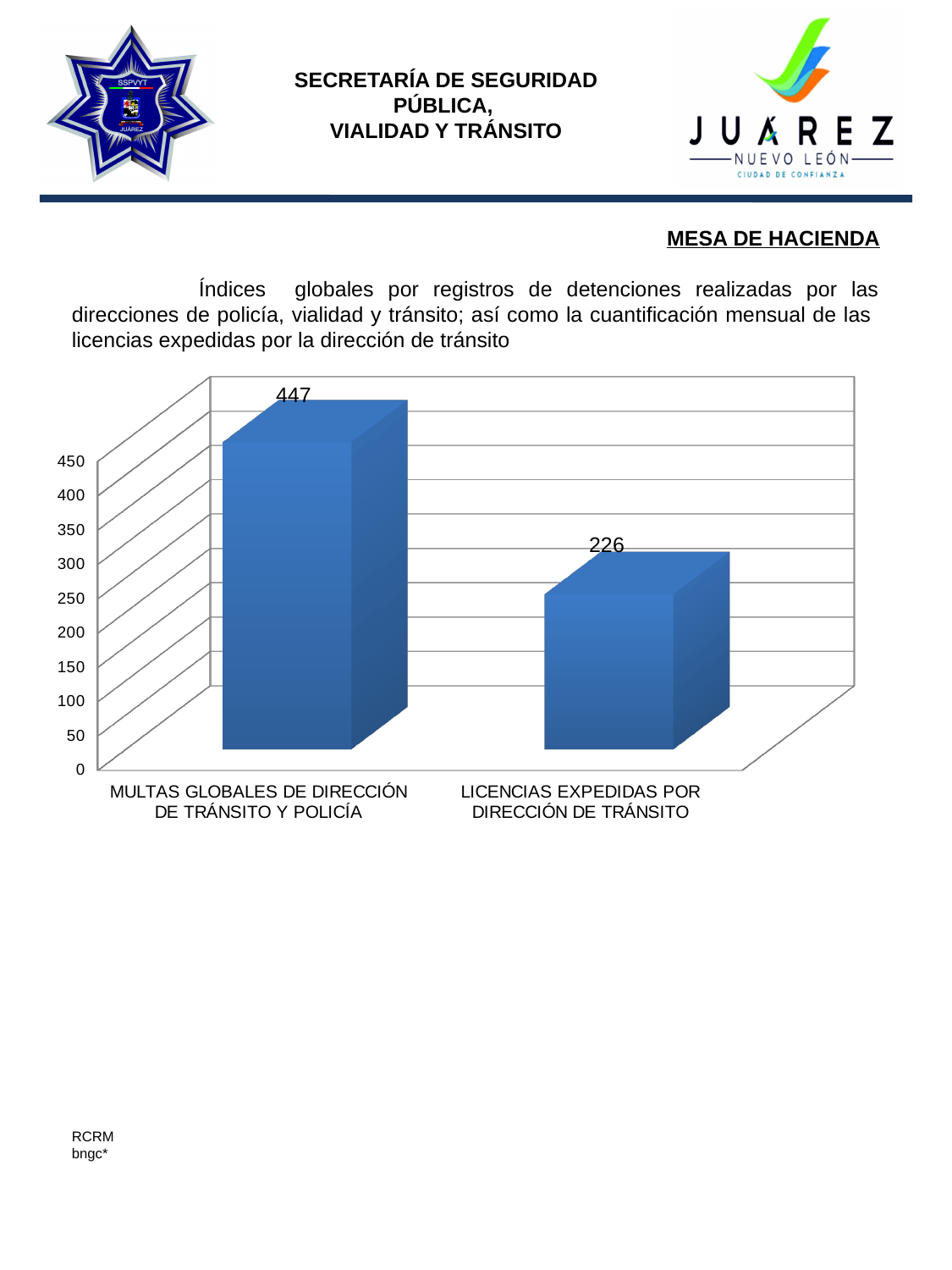
What is the value for LICENCIAS EXPEDIDAS POR DIRECCIÓN DE TRÁNSITO? 226 Is the value for MULTAS GLOBALES DE DIRECCIÓN DE TRÁNSITO Y POLICÍA greater or less than 400? greater What is the total of the two values shown in the chart? 673 Is the value for LICENCIAS EXPEDIDAS POR DIRECCIÓN DE TRÁNSITO greater or less than 250? less Which category has the lowest value? LICENCIAS EXPEDIDAS POR DIRECCIÓN DE TRÁNSITO Which is larger: the value for MULTAS GLOBALES DE DIRECCIÓN DE TRÁNSITO Y POLICÍA or the value for LICENCIAS EXPEDIDAS POR DIRECCIÓN DE TRÁNSITO? MULTAS GLOBALES DE DIRECCIÓN DE TRÁNSITO Y POLICÍA Which category has the highest value? MULTAS GLOBALES DE DIRECCIÓN DE TRÁNSITO Y POLICÍA What is the highest value labelled on the vertical axis? 450 How many categories are shown in the chart? 2 What is the difference between the value for MULTAS GLOBALES DE DIRECCIÓN DE TRÁNSITO Y POLICÍA and the value for LICENCIAS EXPEDIDAS POR DIRECCIÓN DE TRÁNSITO? 221 What is the value for MULTAS GLOBALES DE DIRECCIÓN DE TRÁNSITO Y POLICÍA? 447 What kind of chart is shown on the slide? bar chart